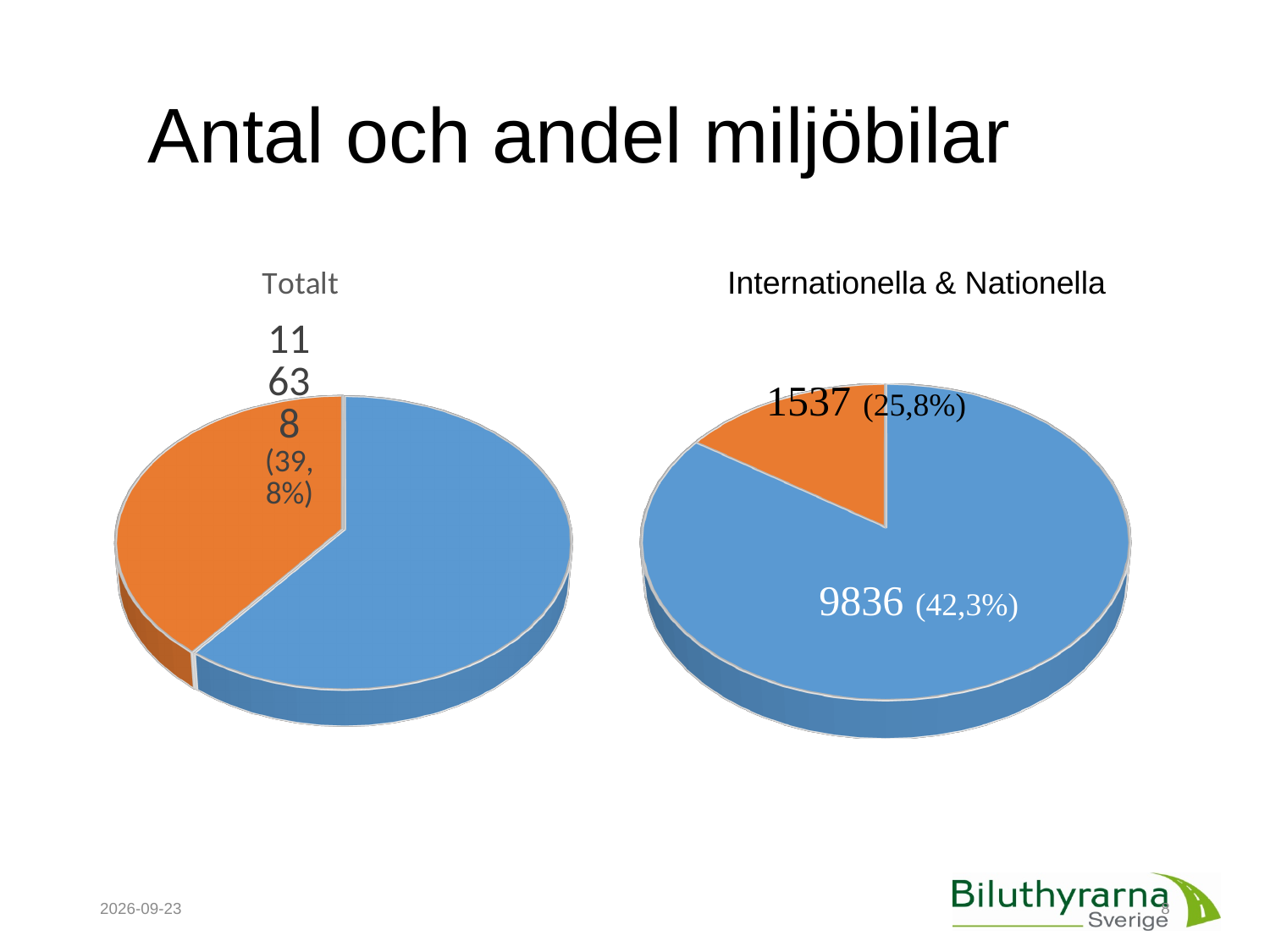
In the chart titled "Totalt", what percentage is printed on the orange slice? 39,8% In the chart titled "Totalt", which slice is larger, the blue one or the orange one? the blue one How many slices does the chart titled "Internationella & Nationella" have? 2 What kind of chart is the chart titled "Internationella & Nationella"? pie chart How many slices does the chart titled "Totalt" have? 2 In the chart titled "Internationella & Nationella", what percentage is printed next to the orange slice? 25,8% In the chart titled "Internationella & Nationella", what value is printed on the orange slice? 1537 (25,8%) What kind of chart is the chart titled "Totalt"? pie chart In the chart titled "Internationella & Nationella", what is the difference between the blue slice value (9836) and the orange slice value (1537)? 8299 In the chart titled "Internationella & Nationella", what value is printed on the blue slice? 9836 (42,3%) In the chart titled "Internationella & Nationella", which slice is larger, the blue one or the orange one? the blue one What is the title of the pie chart on the left of the slide? Totalt